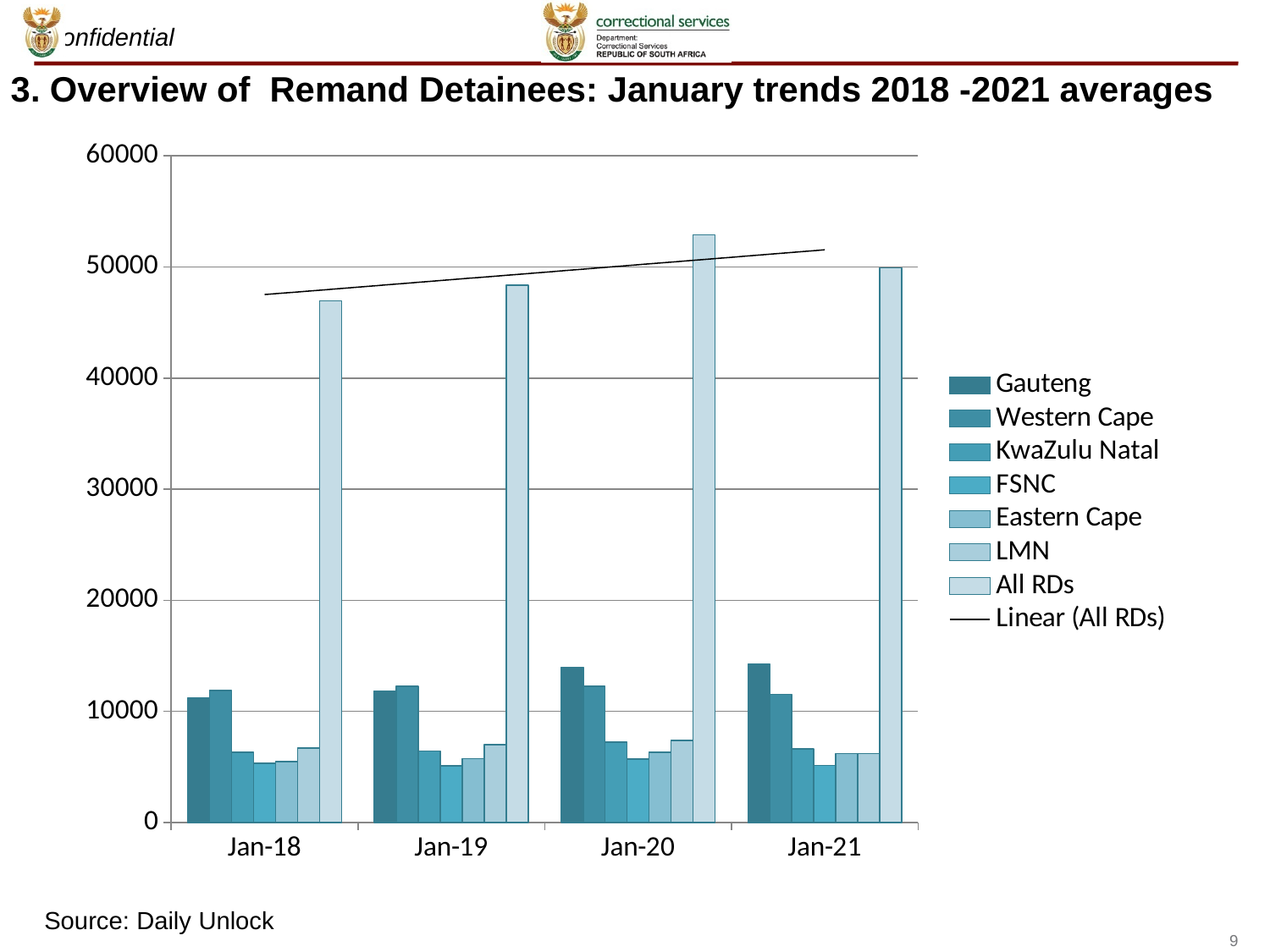
In which January is the All RDs bar the lowest? Jan-18 How many entries does the chart legend list? 8 In Jan-20, which is larger: Gauteng or Western Cape? Gauteng Is the value for Gauteng in Jan-21 greater or less than 10000? greater What kind of chart is shown on the slide? bar chart In Jan-18, which is larger: Gauteng or Western Cape? Western Cape In which January is the All RDs bar the highest? Jan-20 Is the value for All RDs in Jan-18 greater or less than 50000? less What is the title of the slide containing the chart? 3. Overview of Remand Detainees: January trends 2018 -2021 averages Does the Linear (All RDs) trend line rise or fall from Jan-18 to Jan-21? rise How many January periods are shown on the x axis? 4 Is the value for All RDs in Jan-20 greater or less than 50000? greater